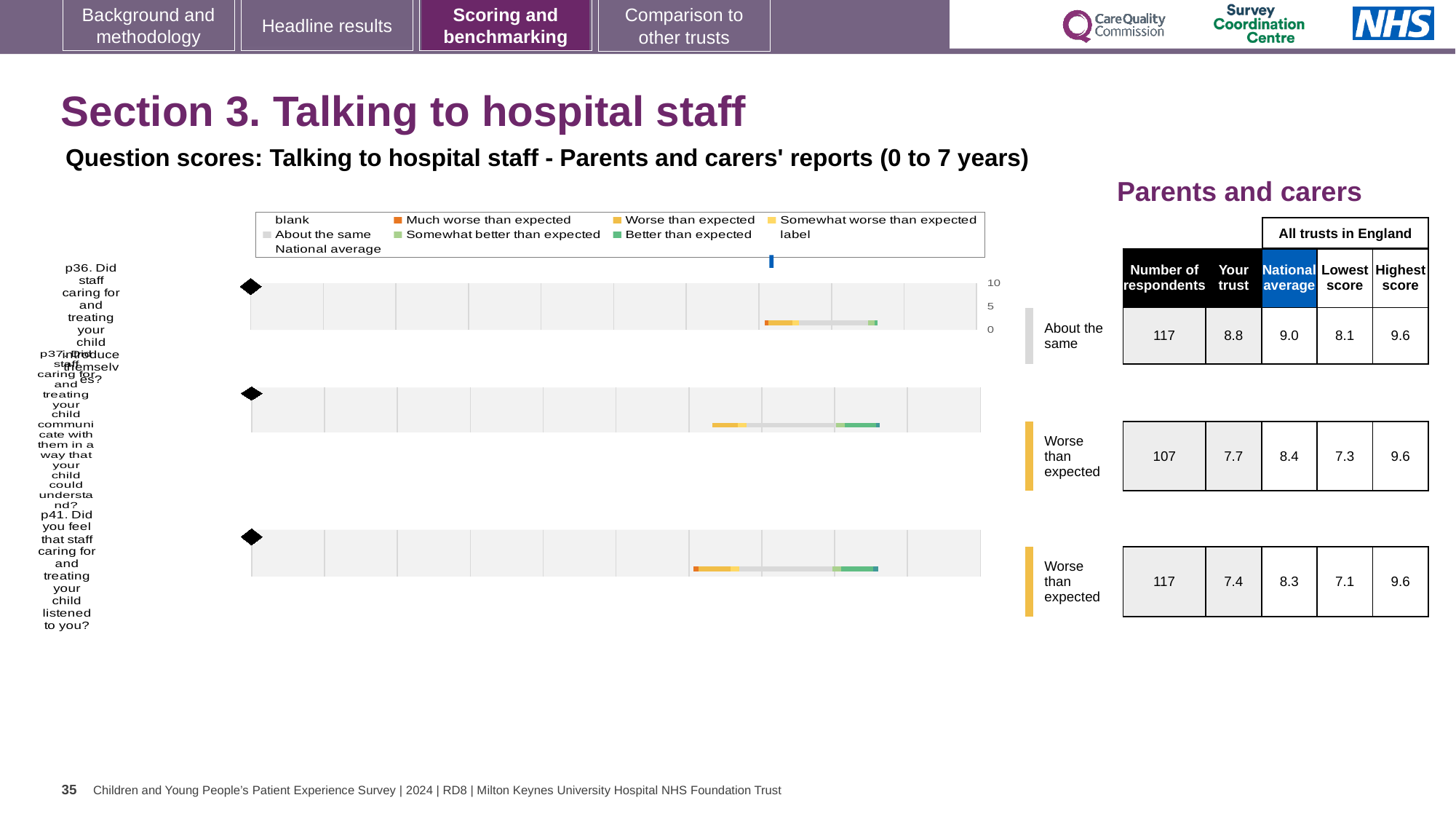
What is the highest score among all trusts in England for question p41? 9.6 Which of the three questions has the highest 'Your trust' score? p36 Is the trust score for p36 higher or lower than the national average for p36? lower Which of the three questions has the lowest 'Your trust' score? p41 What is the 'Your trust' score for question p36 (Did staff caring for and treating your child introduce themselves?)? 8.8 How many respondents answered question p37? 107 What benchmark category is shown for question p36? About the same What is the national average score for question p37 (Did staff communicate with them in a way that your child could understand?)? 8.4 How many question rows (categories) are plotted in the chart? 3 What is the 'Your trust' score for question p41 (Did you feel that staff caring for and treating your child listened to you?)? 7.4 What is the lowest score among all trusts in England for question p37? 7.3 What is the difference between the national average and the trust score for question p41? 0.9